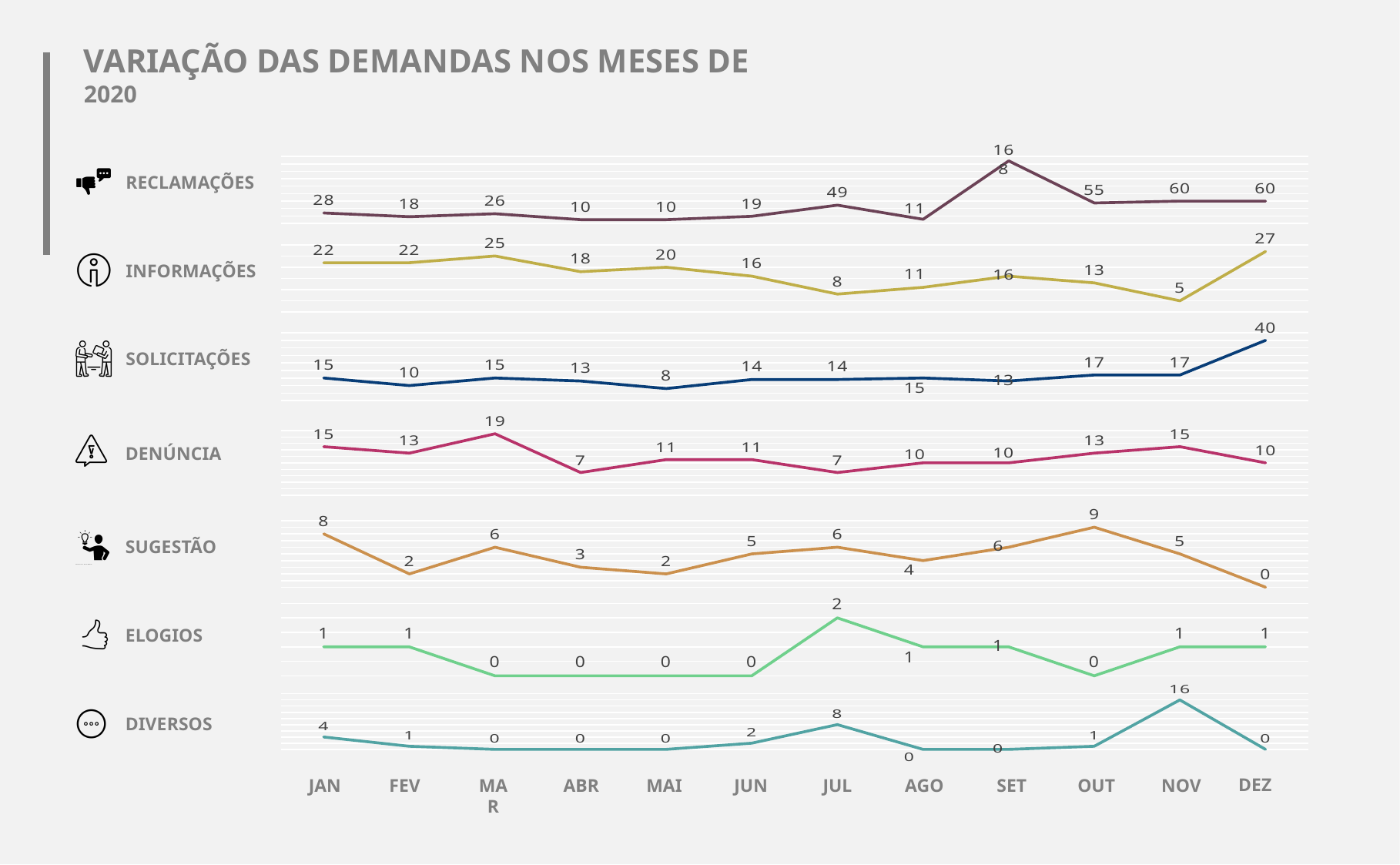
What kind of chart is used to show the demand variation? Line chart What is the value for DENÚNCIA in MAR? 19 In which month is INFORMAÇÕES lowest? NOV What is the difference between the SUGESTÃO values in JAN and FEV? 6 Which is larger, RECLAMAÇÕES in JUL or RECLAMAÇÕES in AGO? JUL How many months are shown on the x axis? 12 How many demand categories (series) are listed on the left of the chart? 7 What is the value for INFORMAÇÕES in DEZ? 27 What is the value for SOLICITAÇÕES in MAI? 8 What is the value for DIVERSOS in NOV? 16 In which month is SUGESTÃO highest? OUT In which month is SOLICITAÇÕES highest? DEZ